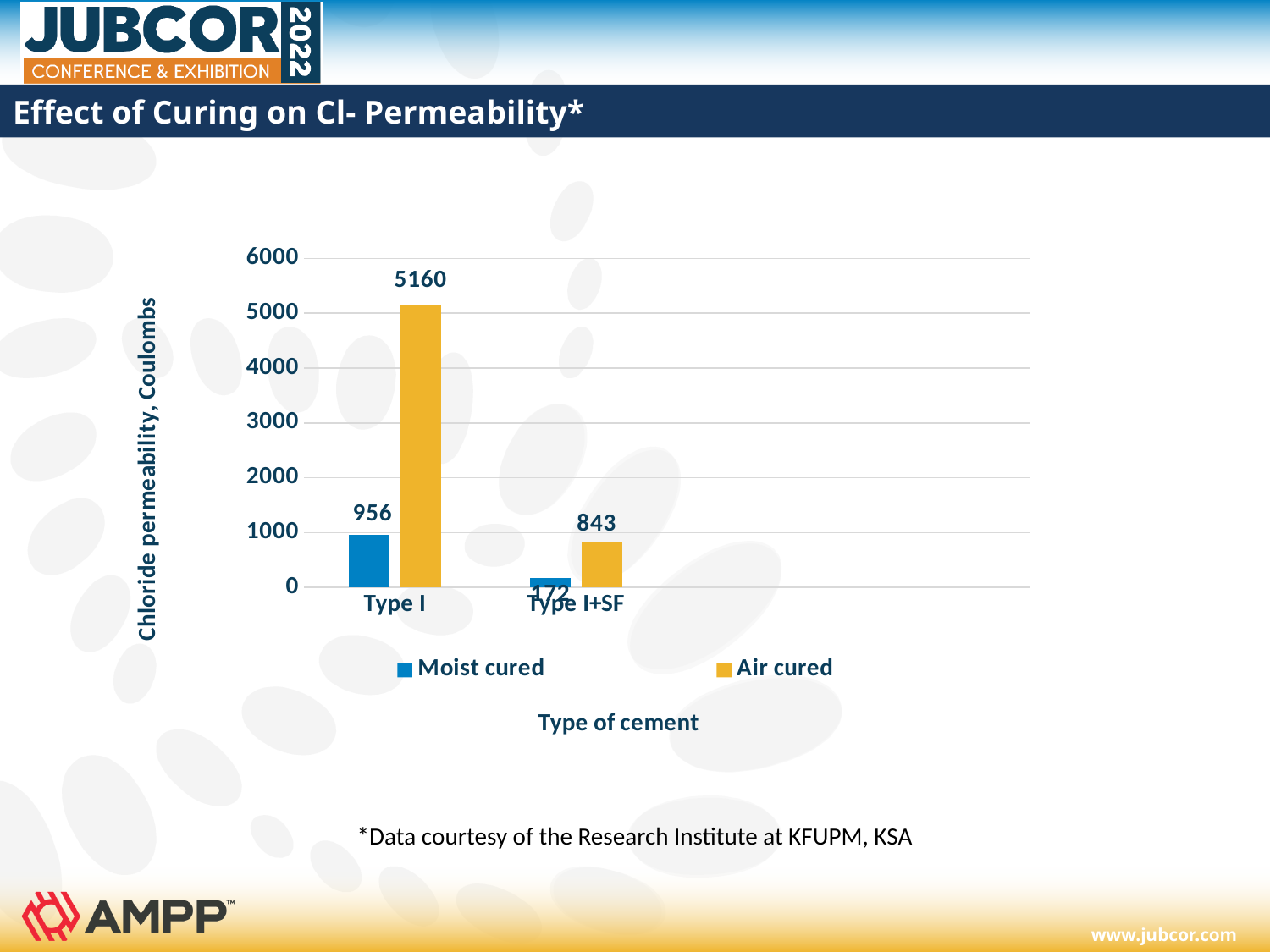
How many types of cement are shown on the x axis? 2 Which is larger, the air cured value for Type I+SF or the moist cured value for Type I? Moist cured value for Type I What is the difference between the moist cured values for Type I and Type I+SF? 784 What kind of chart is shown on the slide? Bar chart What is the chloride permeability for Type I cement when moist cured? 956 What is the chloride permeability for Type I+SF cement when air cured? 843 How many series does the legend list? 2 Which bar shows the lowest chloride permeability? Type I+SF, Moist cured What is the chloride permeability for Type I cement when air cured? 5160 What is the difference between the air cured and moist cured values for Type I cement? 4204 What is the chloride permeability for Type I+SF cement when moist cured? 172 Which bar shows the highest chloride permeability? Type I, Air cured